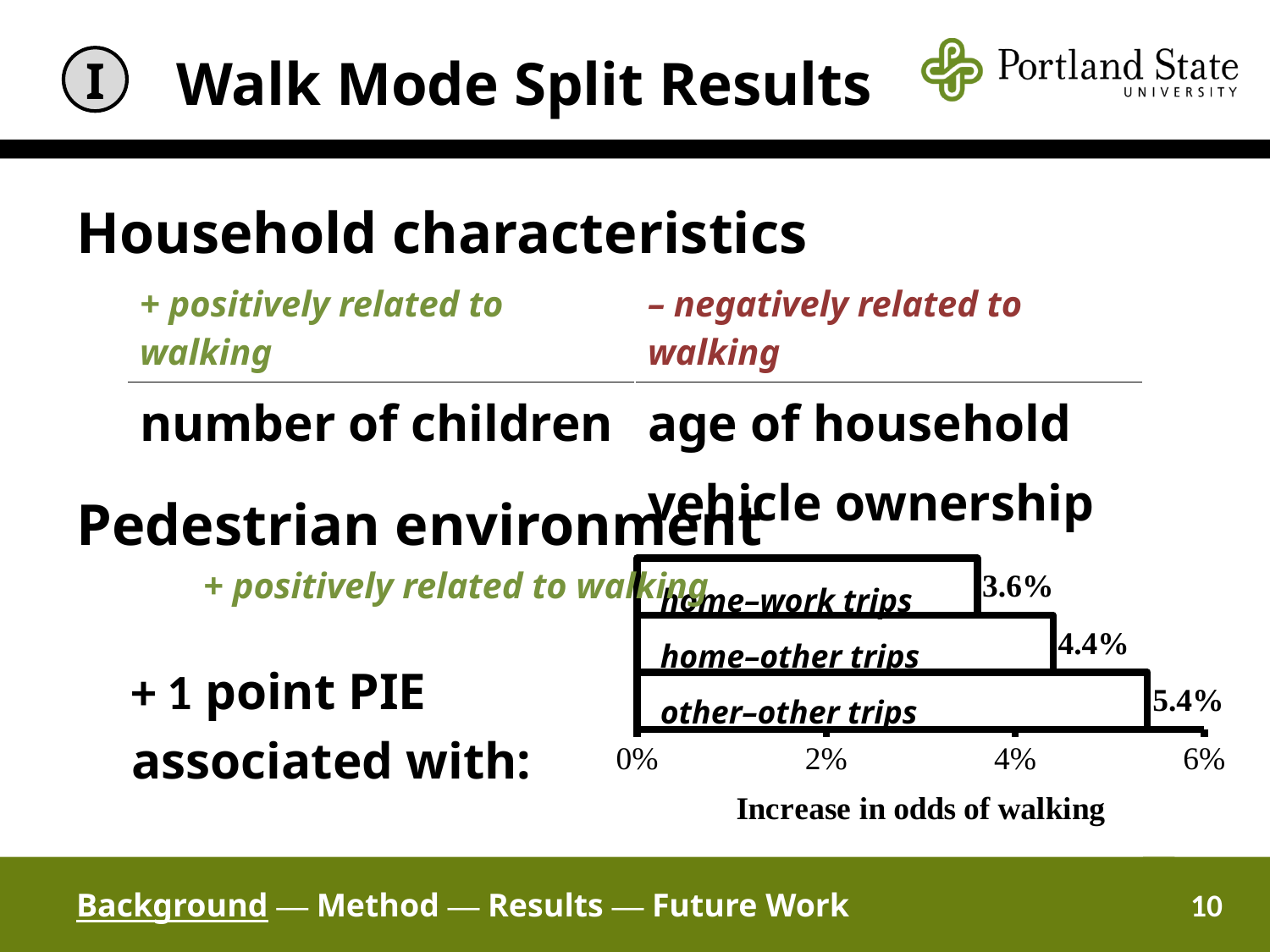
What is the title of the horizontal axis of the chart? Increase in odds of walking Is the value for other–other trips greater or less than 4%? greater What is the difference between the values for other–other trips and home–work trips? 1.8% What is the increase in odds of walking for home–work trips? 3.6% Which trip type has the highest increase in odds of walking? other–other trips What is the difference between the values for home–other trips and home–work trips? 0.8% What kind of chart is shown on the slide? bar chart How many trip types are shown in the chart? 3 What is the increase in odds of walking for other–other trips? 5.4% What is the increase in odds of walking for home–other trips? 4.4% Which is larger, the value for home–other trips or the value for home–work trips? home–other trips Which trip type has the lowest increase in odds of walking? home–work trips